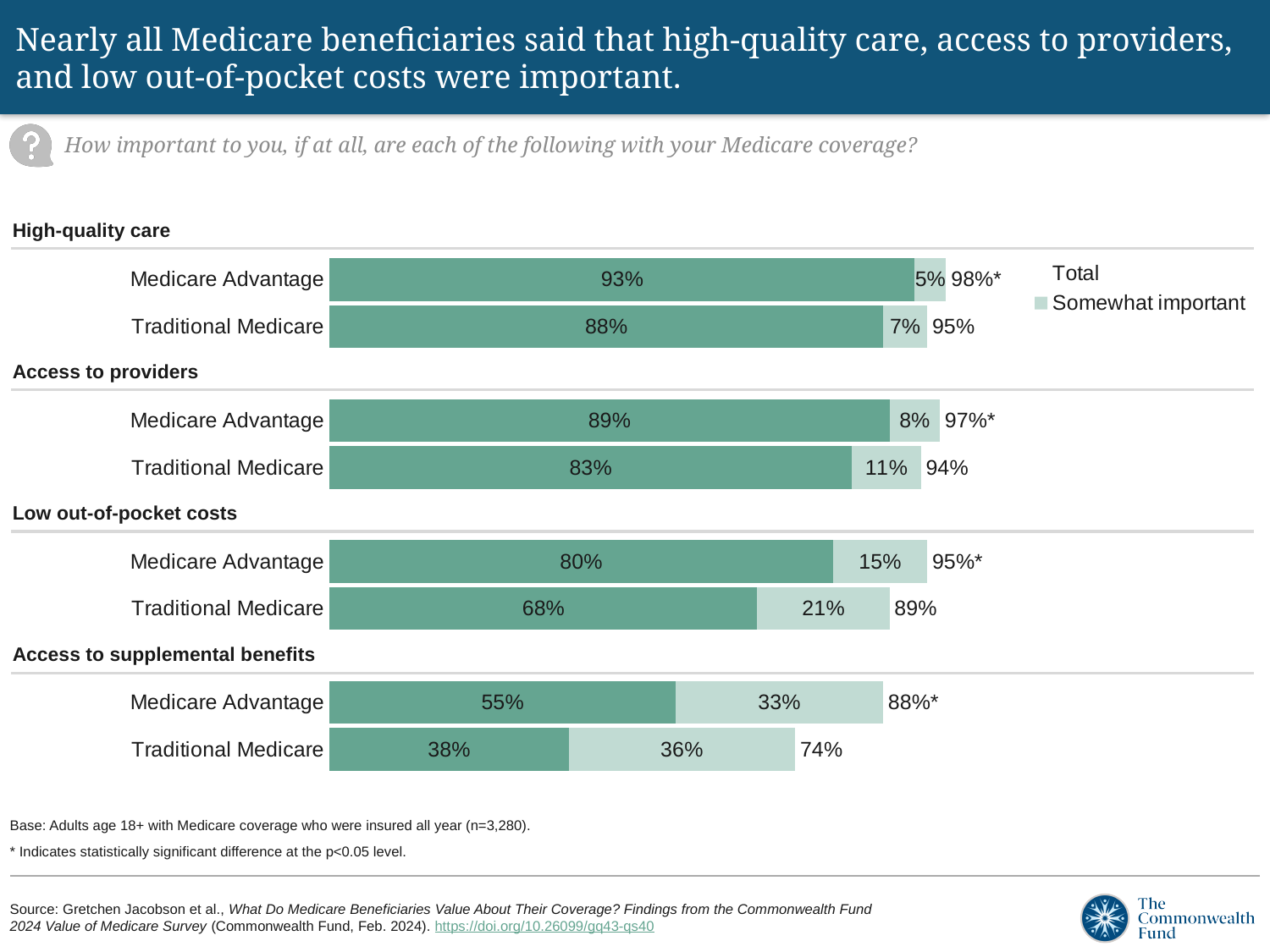
How many coverage items (e.g., High-quality care) are shown in the chart? 4 What is the total percentage for Medicare Advantage under Access to supplemental benefits? 88% Which item has the lowest total percentage for Traditional Medicare? Access to supplemental benefits What response category does the legend label the lighter green segment as? Somewhat important What is the value of the darker green segment for Traditional Medicare under Low out-of-pocket costs? 68% Under Low out-of-pocket costs, which group has the larger 'Somewhat important' share: Medicare Advantage or Traditional Medicare? Traditional Medicare What percentage of Medicare Advantage beneficiaries said high-quality care was somewhat important (the lighter green segment)? 5% Which item has the highest total percentage for Medicare Advantage? High-quality care Under Low out-of-pocket costs, how many percentage points higher is the Medicare Advantage total than the Traditional Medicare total? 6 percentage points What is the value of the lighter green 'Somewhat important' segment for Traditional Medicare under Access to supplemental benefits? 36% What is the total percentage shown for Traditional Medicare under Access to providers? 94% What type of chart is shown on the slide? Bar chart